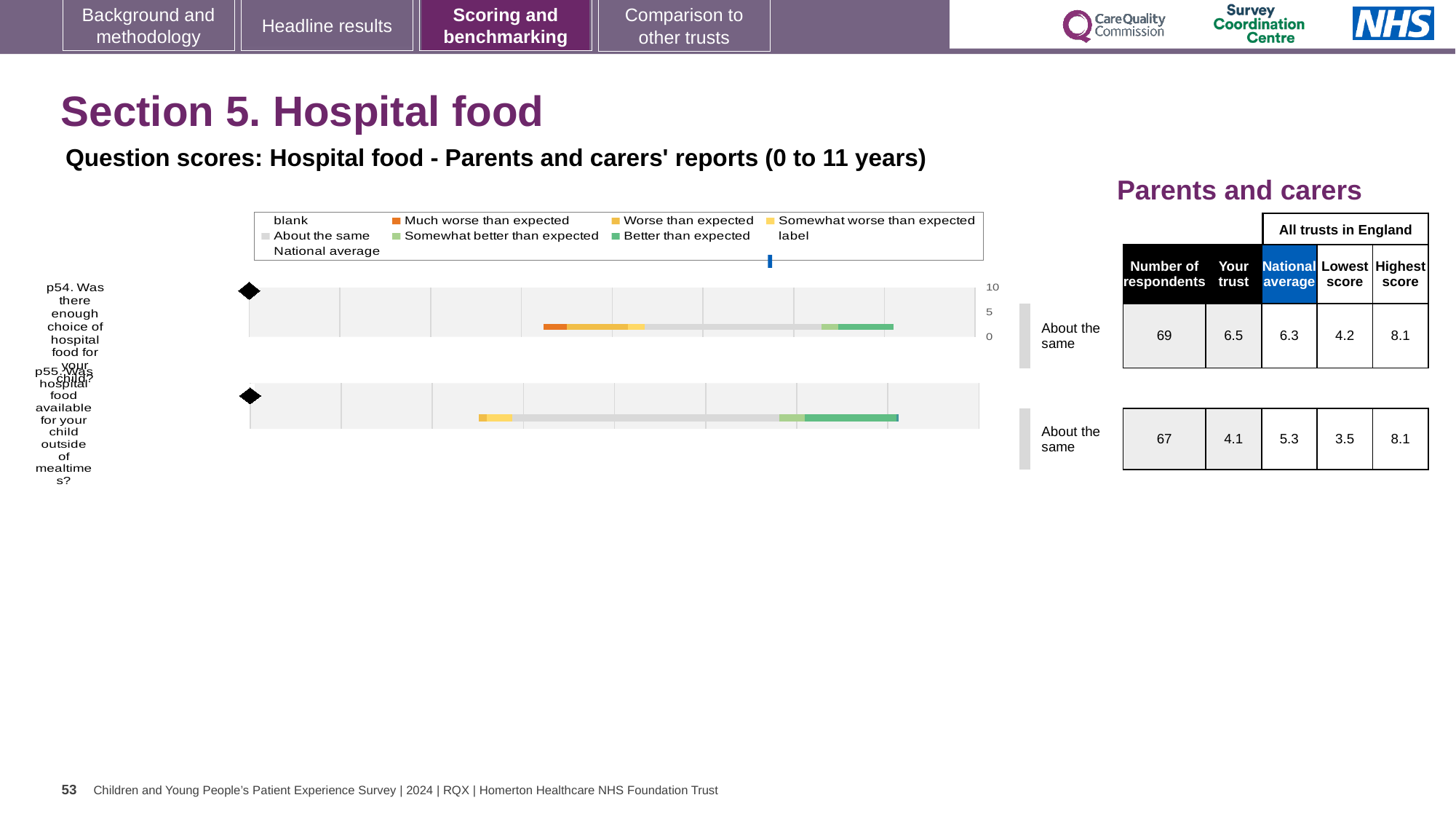
What is the difference between the 'Your trust' score and the national average for p54? 0.2 What is the highest score across all trusts in England for p54? 8.1 What is the national average score for p55? 5.3 What is the 'Your trust' score for p54 (enough choice of hospital food for your child)? 6.5 What benchmark category is shown for p54 in the hospital food chart? About the same Which question has the higher 'Your trust' score, p54 or p55? p54 What is the lowest score across all trusts in England for p55? 3.5 What kind of chart is used to show the question scores for hospital food? bar chart How many respondents answered question p54? 69 How many questions (categories) are plotted in the hospital food chart? 2 What is the 'Your trust' score for p55 (hospital food available outside of mealtimes)? 4.1 What is the difference between the national average and the 'Your trust' score for p55? 1.2